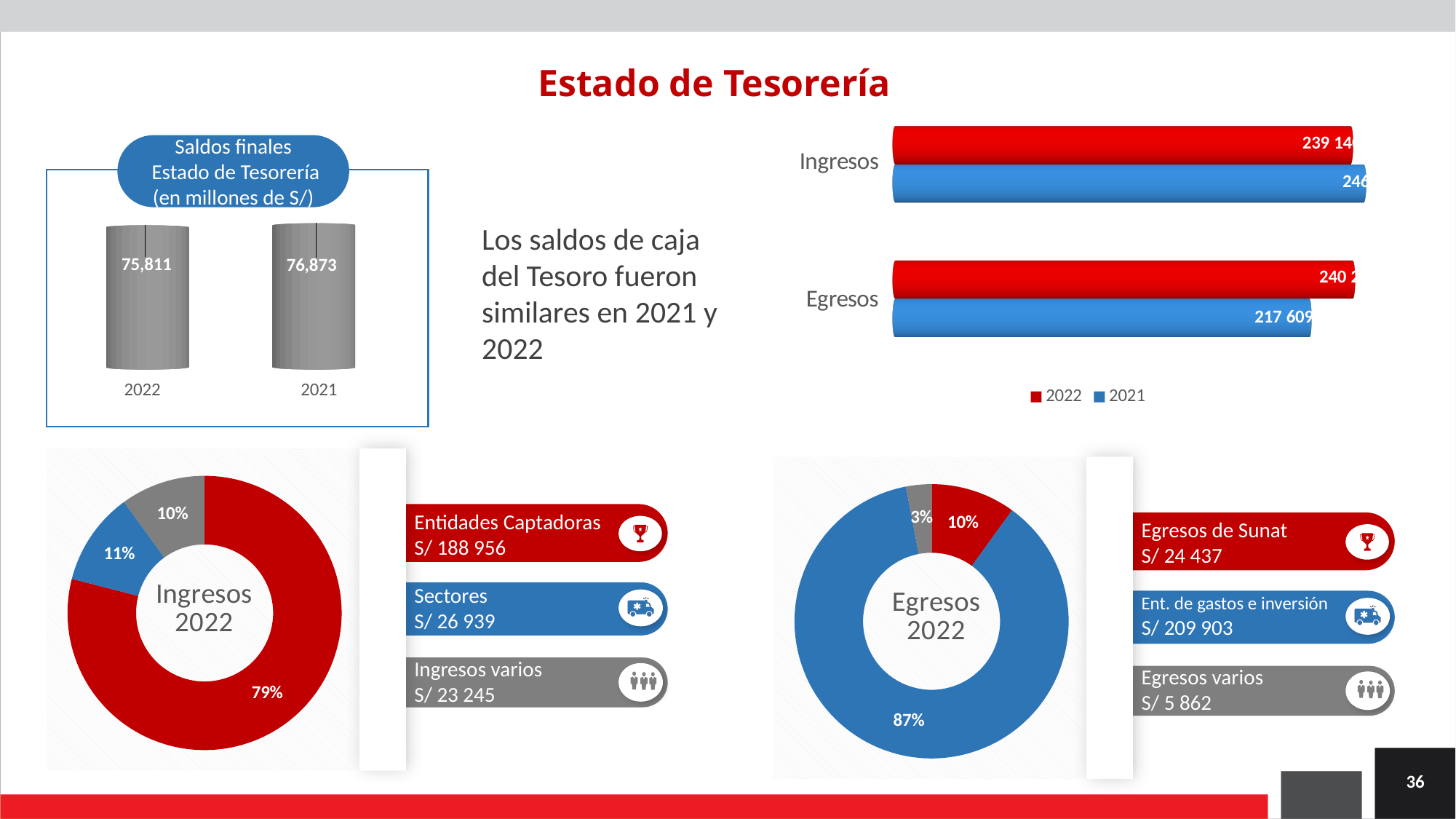
In the 'Ingresos 2022' donut chart, what share does the largest slice (Entidades Captadoras) have? 79% What kind of chart is the chart at the top right showing Ingresos and Egresos? Bar chart In the 'Egresos 2022' donut chart, what share does the smallest slice (Egresos varios) have? 3% In the 'Saldos finales Estado de Tesorería' chart, which year has the higher value? 2021 In the horizontal bar chart at the top right, what is the value of Egresos for 2021? 217 609 In the 'Saldos finales Estado de Tesorería' chart, what is the value for 2022? 75,811 In the horizontal bar chart at the top right, how many series does the legend list? 2 In the horizontal bar chart at the top right, which year has the larger Egresos value, 2022 or 2021? 2022 In the 'Egresos 2022' donut chart, which category has the largest share? Ent. de gastos e inversión In the 'Saldos finales Estado de Tesorería' chart, how many categories are shown? 2 In the 'Saldos finales Estado de Tesorería' chart, what is the value for 2021? 76,873 In the 'Saldos finales Estado de Tesorería' chart, what is the difference between the 2021 and 2022 values? 1,062